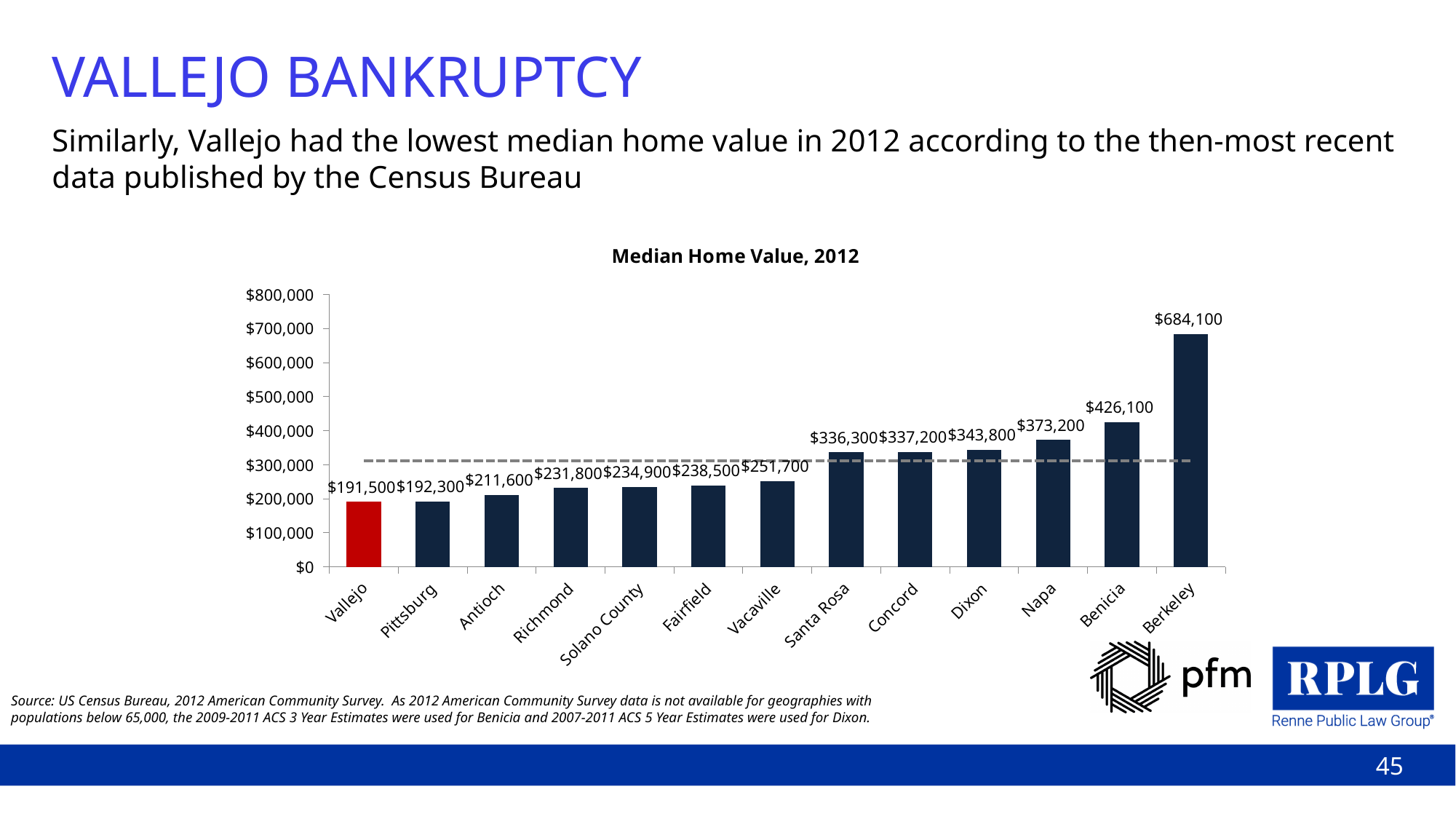
What is the difference between the median home values of Berkeley and Vallejo? $492,600 Which has a higher median home value, Fairfield or Vacaville? Vacaville Which city has the highest median home value in the chart? Berkeley What is the median home value shown for Vallejo? $191,500 What is the median home value shown for Napa? $373,200 What is the title of the chart? Median Home Value, 2012 What is the median home value shown for Solano County? $234,900 What type of chart is used to show median home values? Bar chart What is the median home value shown for Berkeley? $684,100 Which city has the lowest median home value in the chart? Vallejo How many cities or counties are shown on the x axis of the chart? 13 What is the difference between the median home values of Benicia and Napa? $52,900